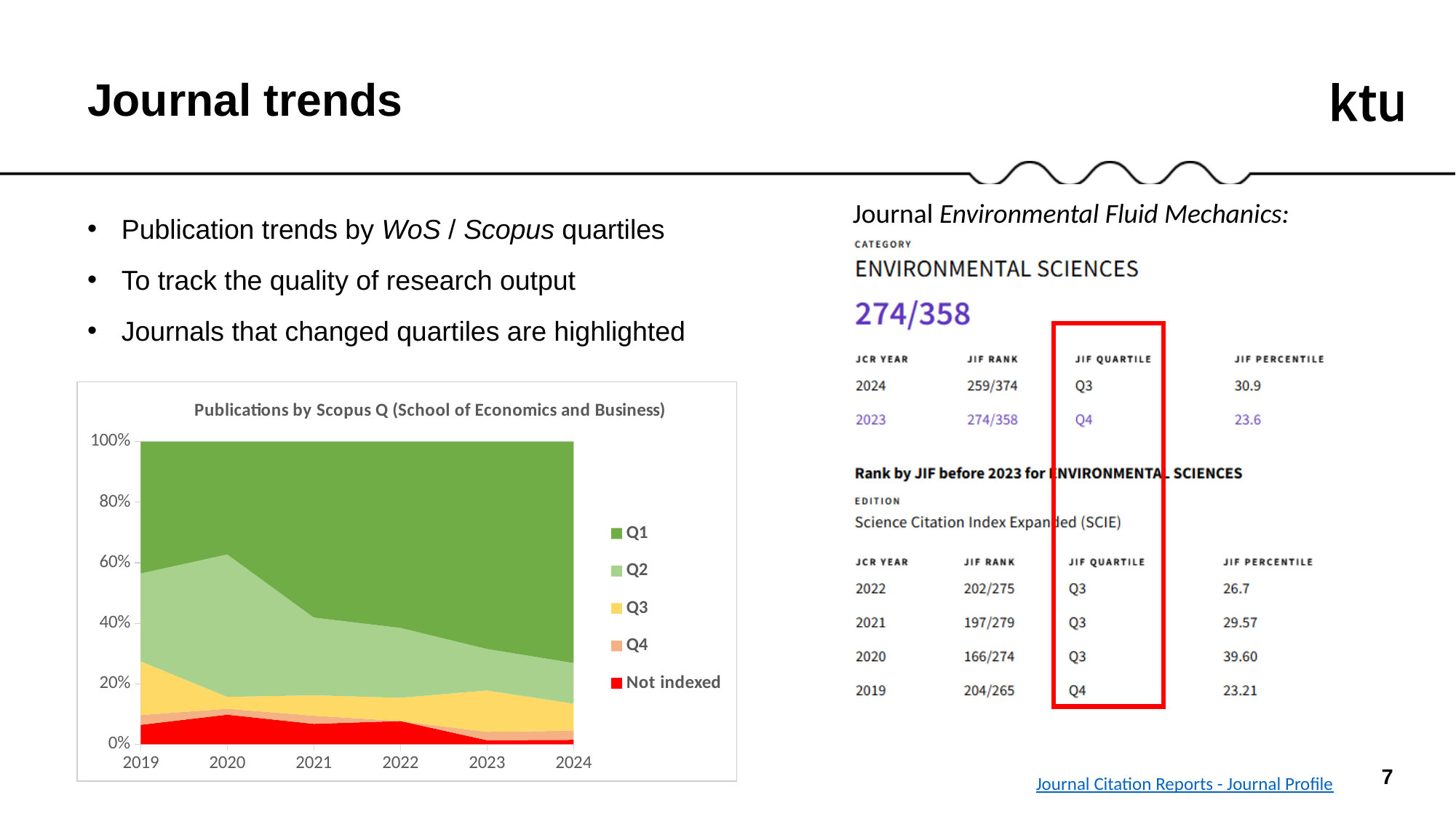
Is the share of Q2 publications larger in 2020 or in 2024? 2020 Is the share of Q1 publications in 2019 greater or less than 60%? less Is the share of Q1 publications larger in 2019 or in 2024? 2024 What kind of chart is shown on the slide? Area chart Which series is shown in red in the chart's legend? Not indexed Does the share of Q1 publications rise or fall from 2019 to 2024? rise What is the title of the chart on the slide? Publications by Scopus Q (School of Economics and Business) Does the share of Not indexed publications rise or fall from 2020 to 2024? fall How many series does the chart's legend list? 5 Is the share of Q1 publications in 2024 greater or less than 60%? greater How many years are shown along the x axis of the chart? 6 Is the share of Not indexed publications in 2020 greater or less than 20%? less